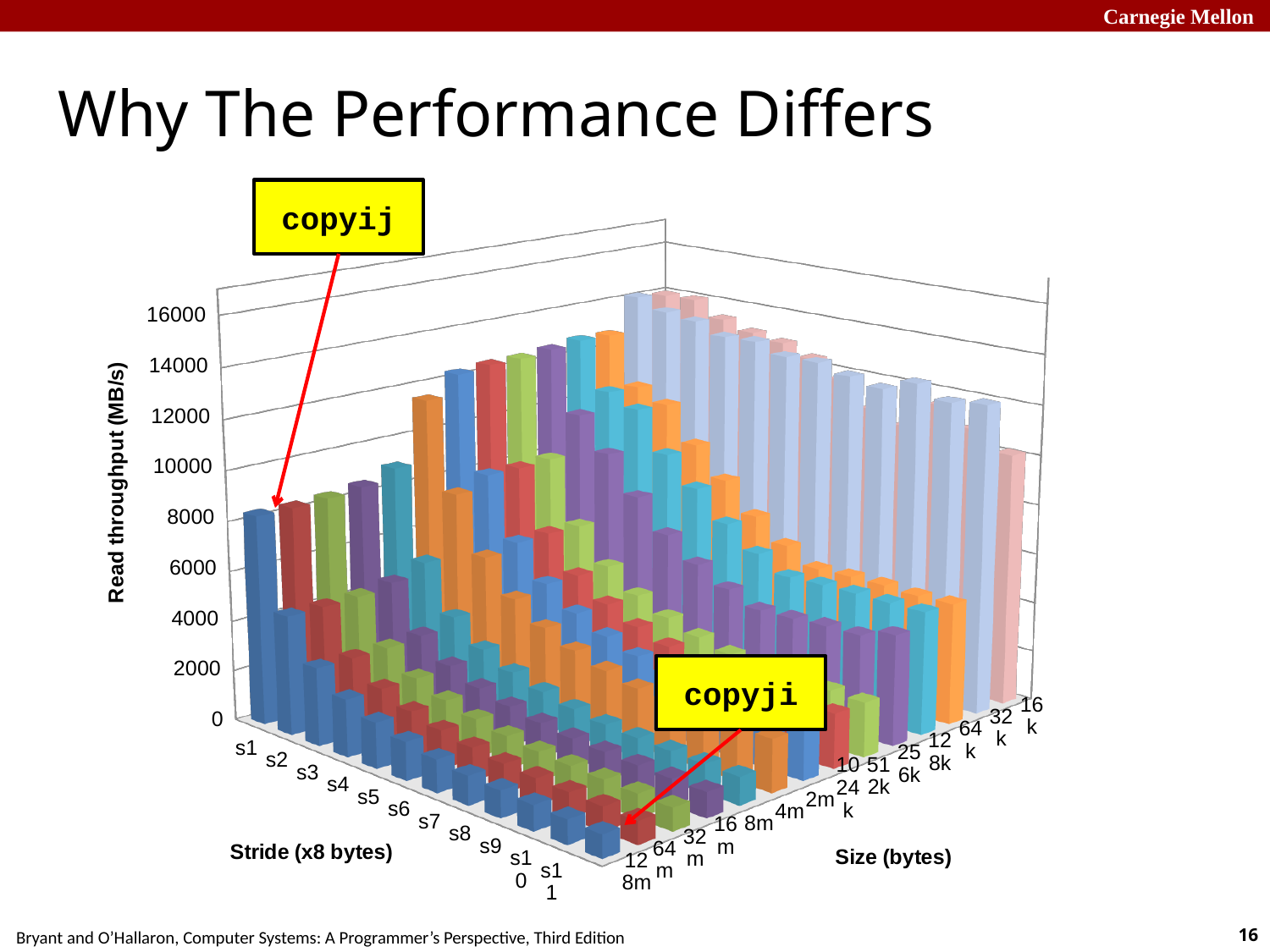
What is the highest value labelled on the Read throughput (MB/s) axis? 16000 For the 128m size, do the read throughput values rise or fall as the stride increases from s1 to s11? fall Is the read throughput for stride s1 at size 32k greater or less than 12000? greater How many stride categories are shown along the Stride (x8 bytes) axis? 11 Which size has the higher read throughput at stride s1: 32k or 128m? 32k What kind of chart is shown on the slide? 3D bar chart How many size categories are shown along the Size (bytes) axis? 14 Which stride has the higher read throughput at size 128m: s1 or s11? s1 Is the read throughput for stride s11 at size 128m greater or less than 2000? less What is the label of the vertical axis? Read throughput (MB/s)